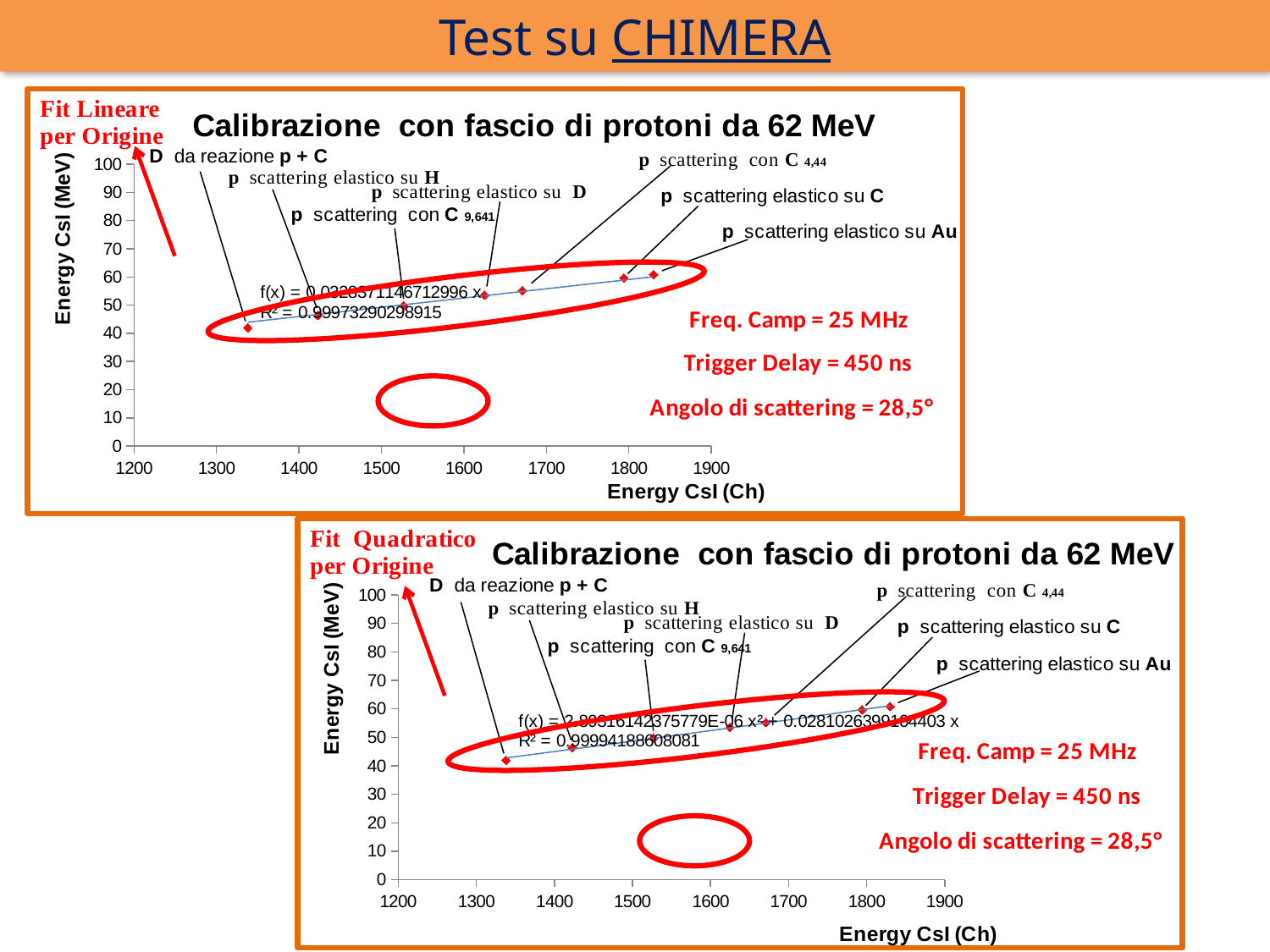
In the top chart (Fit Lineare per Origine), is the Energy CsI (MeV) value for 'p scattering elastico su Au' greater or less than 50? greater In the top chart (Fit Lineare per Origine), is the Energy CsI (Ch) value for 'D da reazione p + C' greater or less than 1400? less In the top chart (Fit Lineare per Origine), which labelled point has the lowest Energy CsI (MeV)? D da reazione p + C What kind of chart is the top chart titled 'Calibrazione con fascio di protoni da 62 MeV'? scatter chart In the top chart (Fit Lineare per Origine), what R² value is printed for the linear fit? 0.99973290298915 What is the label of the y axis in the top chart (Fit Lineare per Origine)? Energy CsI (MeV) In the top chart (Fit Lineare per Origine), is the Energy CsI (MeV) value for 'D da reazione p + C' greater or less than 50? less In the top chart (Fit Lineare per Origine), how many data points are plotted? 7 In the top chart (Fit Lineare per Origine), do the plotted energies rise or fall as Energy CsI (Ch) increases? rise What is the label of the x axis in the bottom chart (Fit Quadratico per Origine)? Energy CsI (Ch) Which fit has the higher printed R² value, the linear fit in the top chart or the quadratic fit in the bottom chart? the quadratic fit (bottom chart) In the bottom chart (Fit Quadratico per Origine), what R² value is printed for the quadratic fit? 0.99994188608081